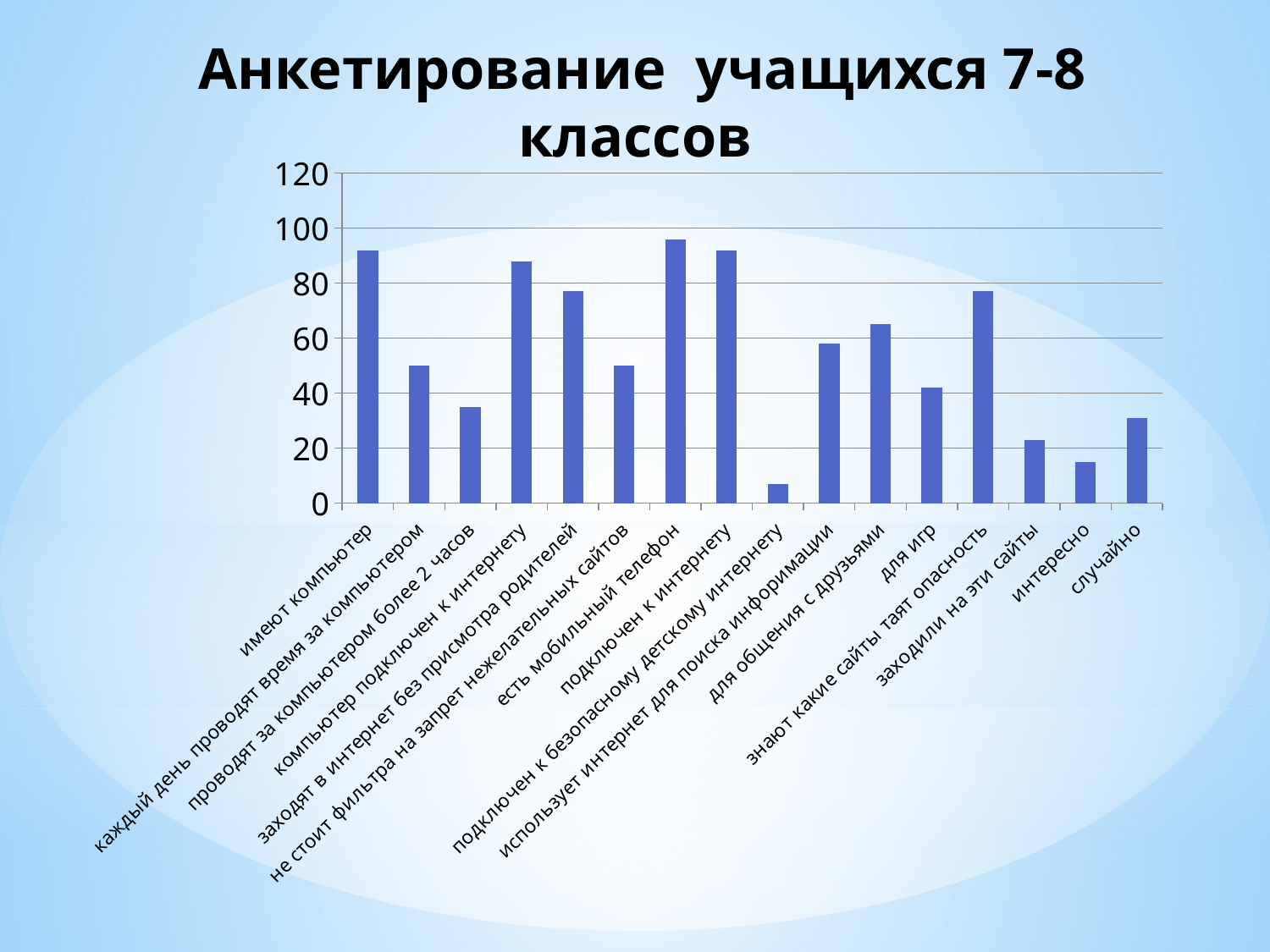
How many categories (bars) does the chart show? 16 Which is larger: the value for 'интересно' or for 'случайно'? случайно Is the value for 'проводят за компьютером более 2 часов' greater or less than 40? less What is the title of the slide containing the chart? Анкетирование учащихся 7-8 классов Is the value for 'подключен к безопасному детскому интернету' greater or less than 20? less Is the value for 'интересно' greater or less than 20? less Which is larger: the value for 'для игр' or for 'для общения с друзьями'? для общения с друзьями What kind of chart is shown on the slide? bar chart Which category has the lowest value in the chart? подключен к безопасному детскому интернету